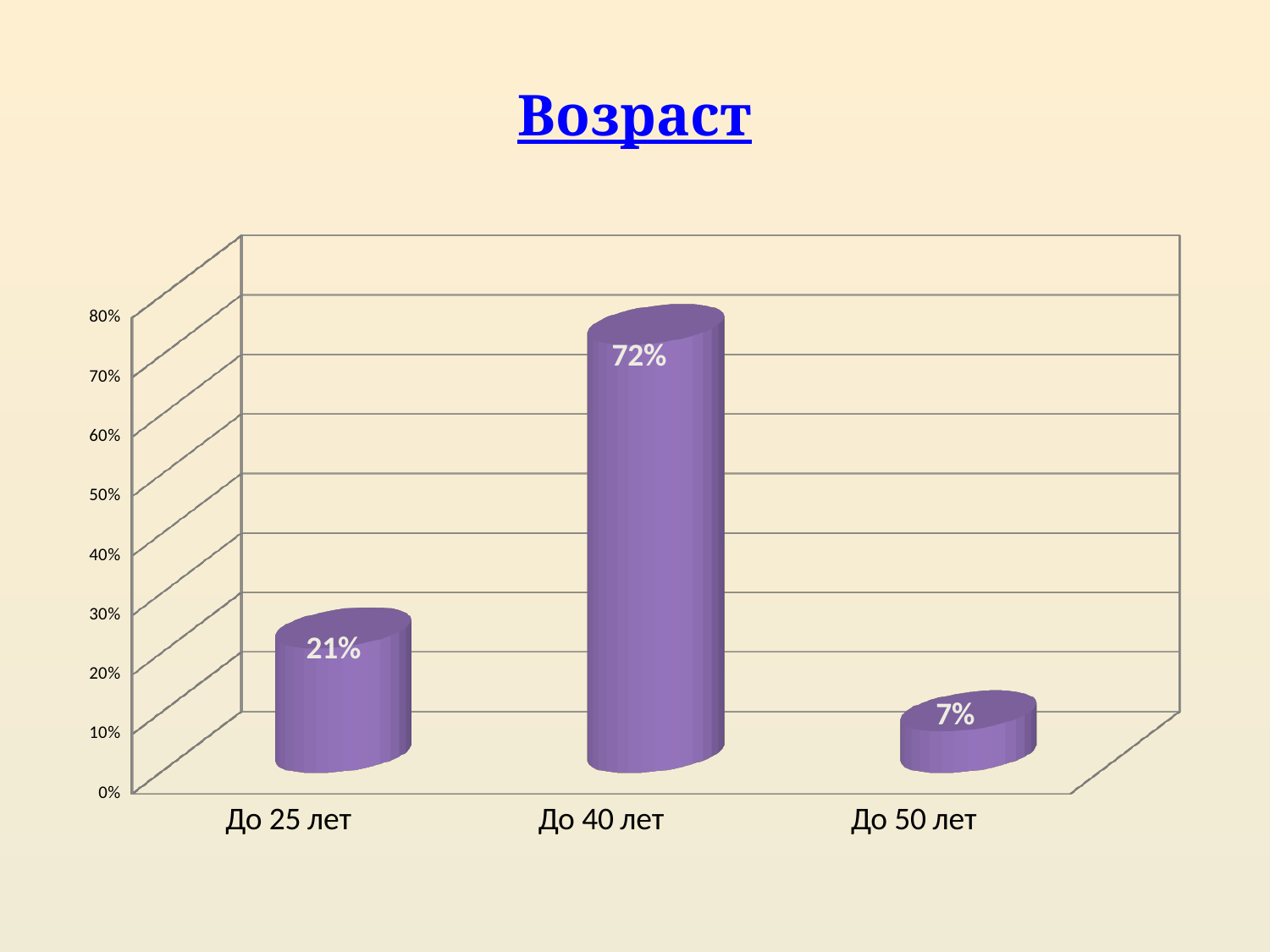
Which category has the lowest value? До 50 лет What is the difference between the values for До 40 лет and До 25 лет? 51% What is the value for До 50 лет? 7% Which is larger, the value for До 25 лет or the value for До 50 лет? До 25 лет What is the difference between the values for До 25 лет and До 50 лет? 14% Which category has the highest value? До 40 лет What is the value for До 40 лет? 72% What is the title of the slide? Возраст How many categories are shown on the chart? 3 Is the value for До 40 лет greater or less than 50%? greater What is the value for До 25 лет? 21% What kind of chart is shown on the slide? bar chart